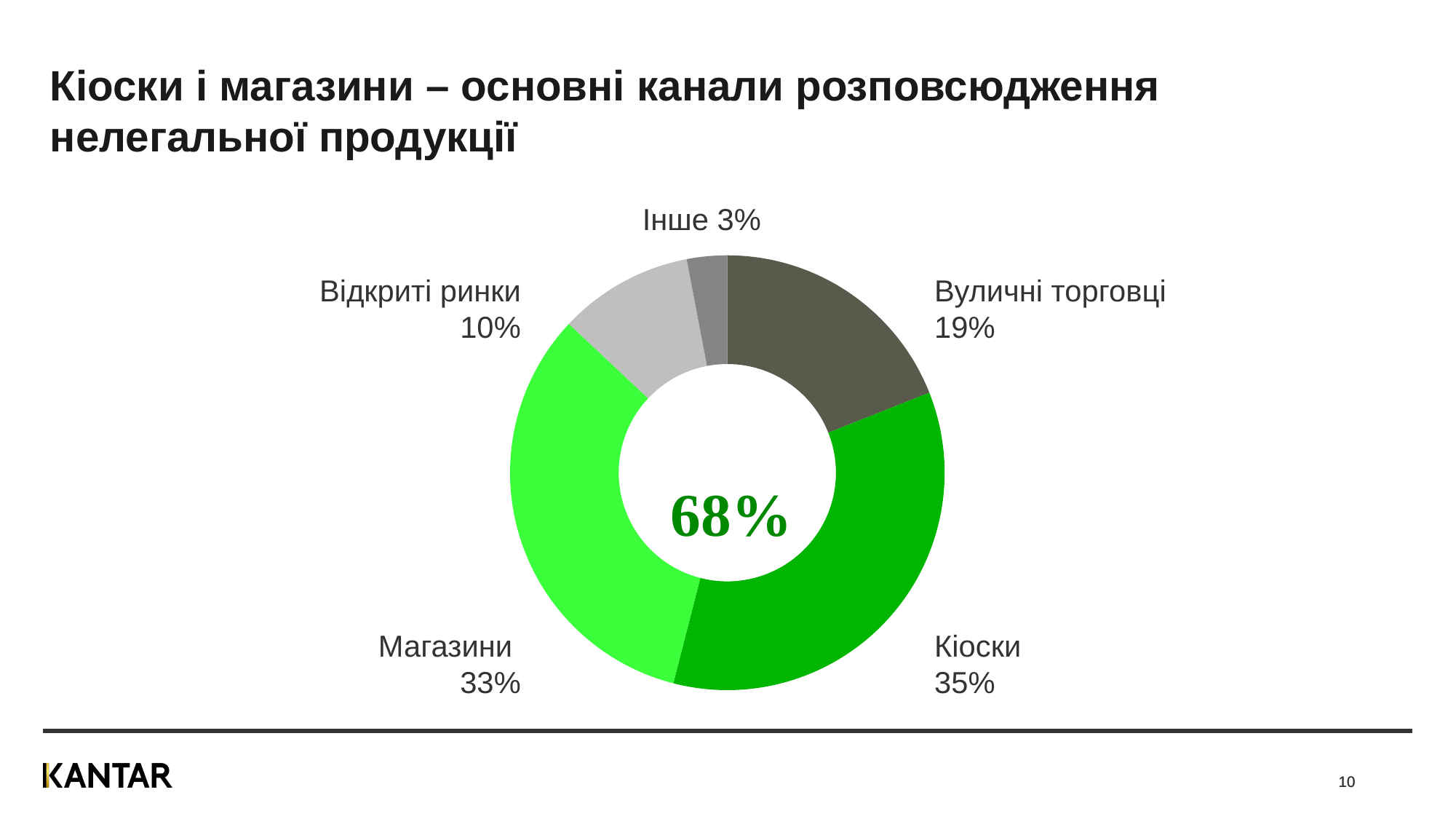
What share does Вуличні торговці have in the chart? 19% What share does Відкриті ринки have in the chart? 10% Which category has the smallest share in the chart? Інше What kind of chart is shown on the slide? Pie chart (doughnut) Which is larger, the share of Магазини or the share of Відкриті ринки? Магазини What is the difference between the shares of Кіоски and Вуличні торговці? 16% How many categories are shown in the chart? 5 What number is printed in the centre of the chart? 68% What share does Кіоски have in the chart? 35% What share does Магазини have in the chart? 33% Which category has the largest share in the chart? Кіоски What share does Інше have in the chart? 3%